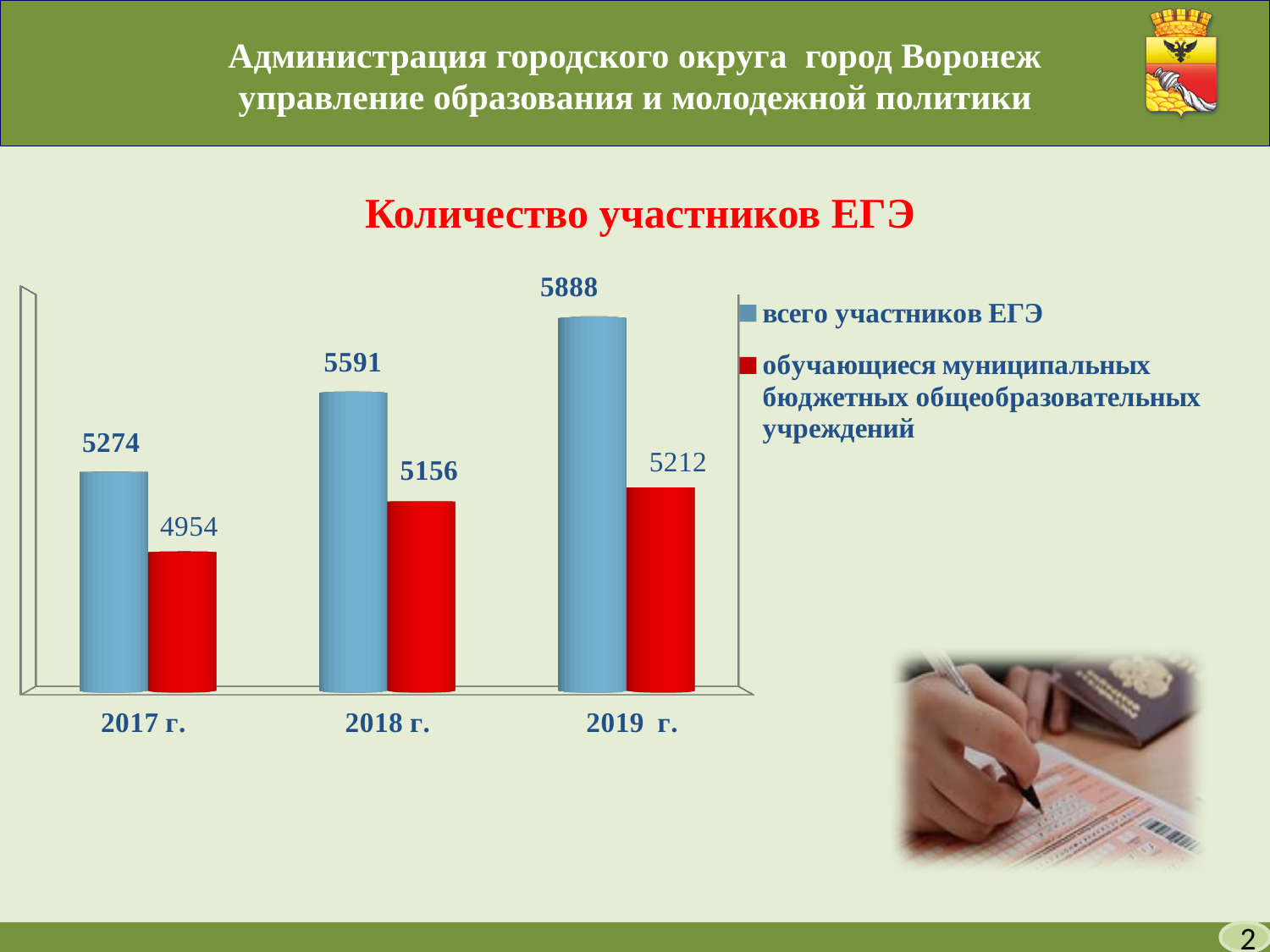
What was the total number of ЕГЭ participants in 2019 г.? 5888 What is the difference between the total number of ЕГЭ participants and the number of students of municipal budget institutions in 2019 г.? 676 In which year was the total number of ЕГЭ participants the highest? 2019 г. Does the total number of ЕГЭ participants rise or fall from 2017 г. to 2019 г.? Rises By how much did the total number of ЕГЭ participants increase from 2017 г. to 2018 г.? 317 What kind of chart is shown on the slide? Bar chart In which year was the number of students of municipal budget general education institutions the lowest? 2017 г. Which is larger: the total number of ЕГЭ participants in 2018 г. or the number of students of municipal budget institutions in 2019 г.? Total ЕГЭ participants in 2018 г. (5591) How many years are shown on the x axis of the chart? 3 How many students of municipal budget general education institutions (обучающиеся муниципальных бюджетных общеобразовательных учреждений) took part in 2018 г.? 5156 What was the total number of ЕГЭ participants (всего участников ЕГЭ) in 2017 г.? 5274 How many series does the legend list? 2